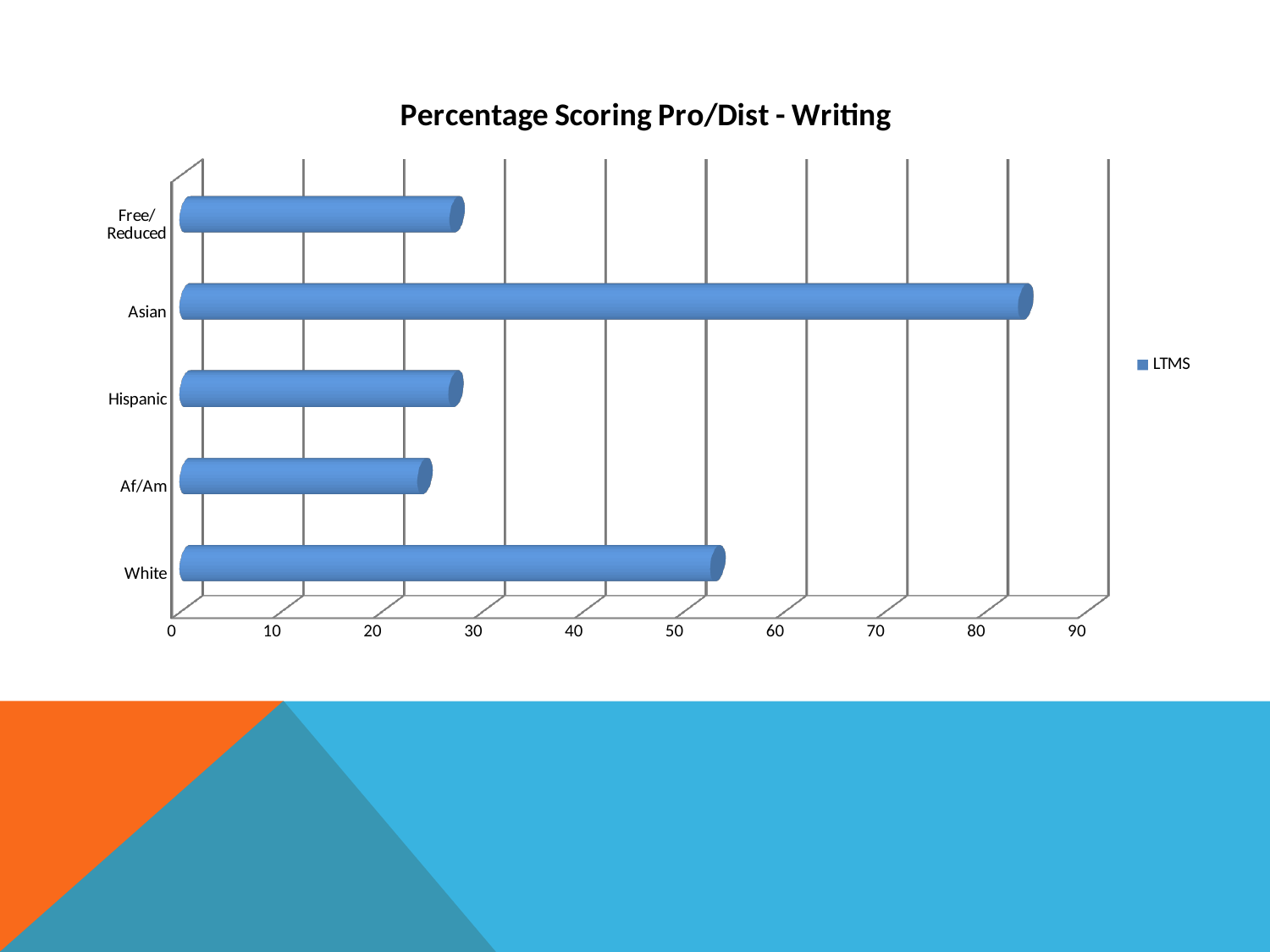
Which category has the highest value? Asian What is the title of the chart? Percentage Scoring Pro/Dist - Writing Is the value for Af/Am greater or less than 30? less Which has a larger value, White or Af/Am? White Is the value for Asian greater or less than 70? greater Is the value for White greater or less than 40? greater What kind of chart is shown on the slide? bar chart What is the name of the series shown in the legend? LTMS How many categories are plotted on the chart? 5 Which has a larger value, Asian or White? Asian Which category has the lowest value? Af/Am How many series does the legend list? 1